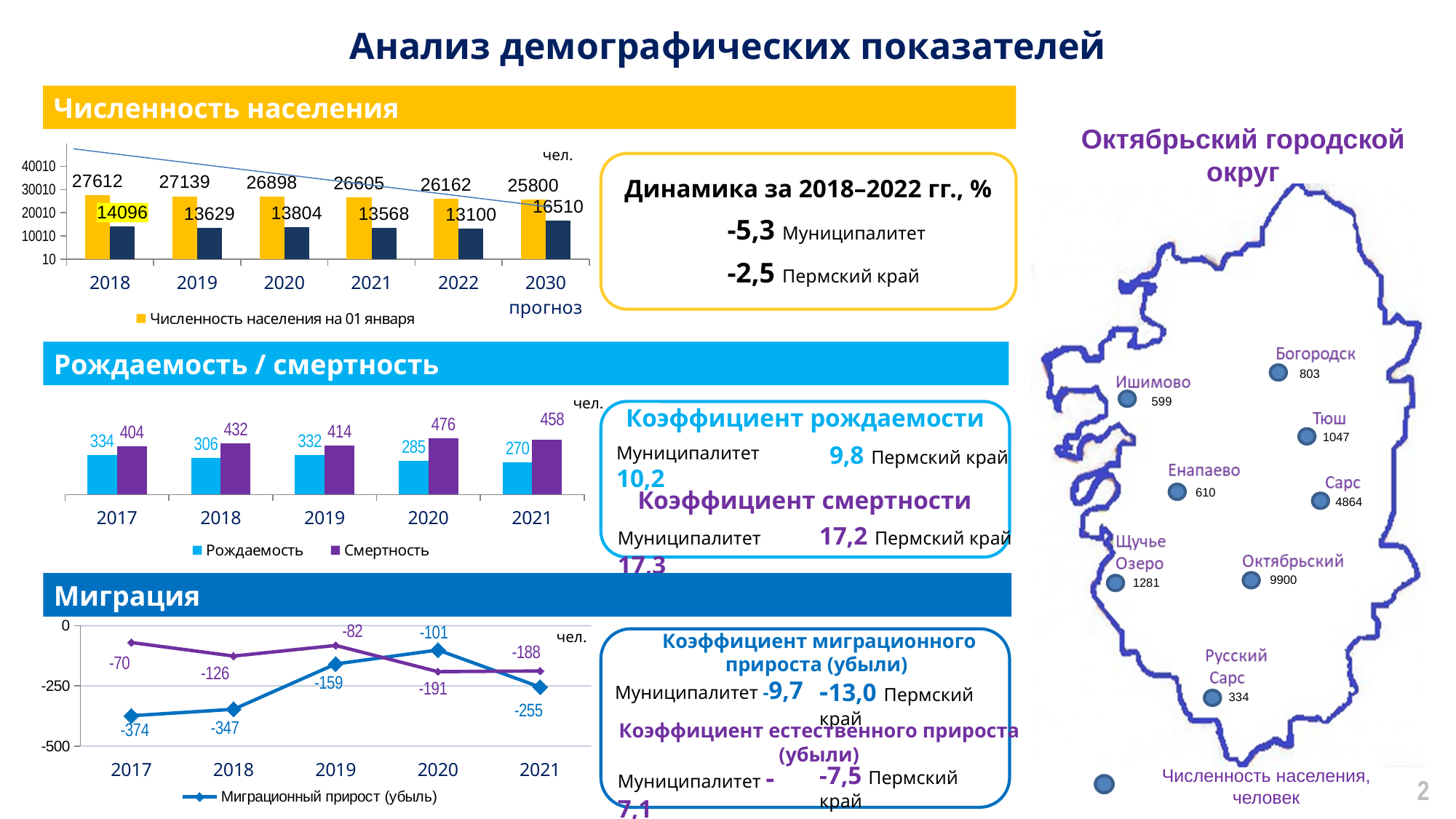
In the 'Рождаемость / смертность' chart, which year has the highest 'Рождаемость' value? 2017 In the 'Рождаемость / смертность' chart, what is the 'Смертность' value for 2020? 476 What kind of chart is the 'Миграция' chart? line chart In the 'Миграция' chart, which year has the highest 'Миграционный прирост (убыль)' value? 2020 In the 'Рождаемость / смертность' chart, what is the difference between 'Смертность' and 'Рождаемость' in 2019? 82 In the 'Рождаемость / смертность' chart, how many series does the legend list? 2 In the 'Численность населения' chart, what is the value of 'Численность населения на 01 января' for 2018? 27612 In the 'Миграция' chart, what is the 'Миграционный прирост (убыль)' value for 2017? -374 In the 'Рождаемость / смертность' chart, what is the 'Рождаемость' value for 2021? 270 In the 'Численность населения' chart, what is the difference between the 'Численность населения на 01 января' values for 2018 and 2022? 1450 In the 'Численность населения' chart, does the 'Численность населения на 01 января' series rise or fall from 2018 to 2022? fall In the 'Численность населения' chart, what is the value of 'Численность населения на 01 января' for the 2030 прогноз? 25800